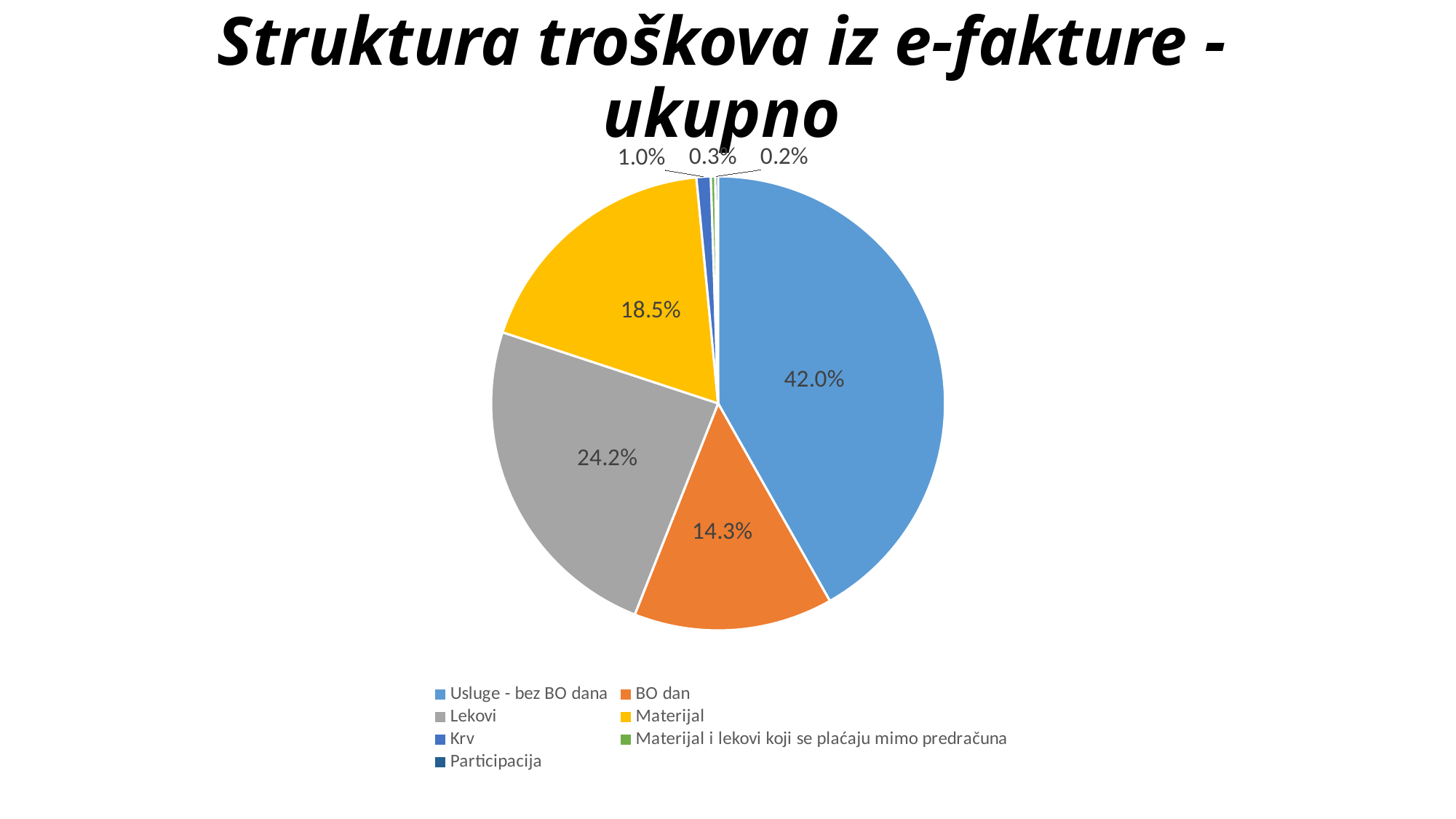
What share of the pie does Krv have? 1.0% What type of chart is shown on the slide? pie chart Which category has the largest slice of the pie? Usluge - bez BO dana What is the title of the chart? Struktura troškova iz e-fakture - ukupno What share of the pie does Usluge - bez BO dana have? 42.0% How many categories does the legend list? 7 What share of the pie does Materijal have? 18.5% What colour is the slice for Materijal? yellow What is the difference between the shares of Usluge - bez BO dana and Lekovi? 17.8% Which is larger, the slice for Lekovi or the slice for Materijal? Lekovi